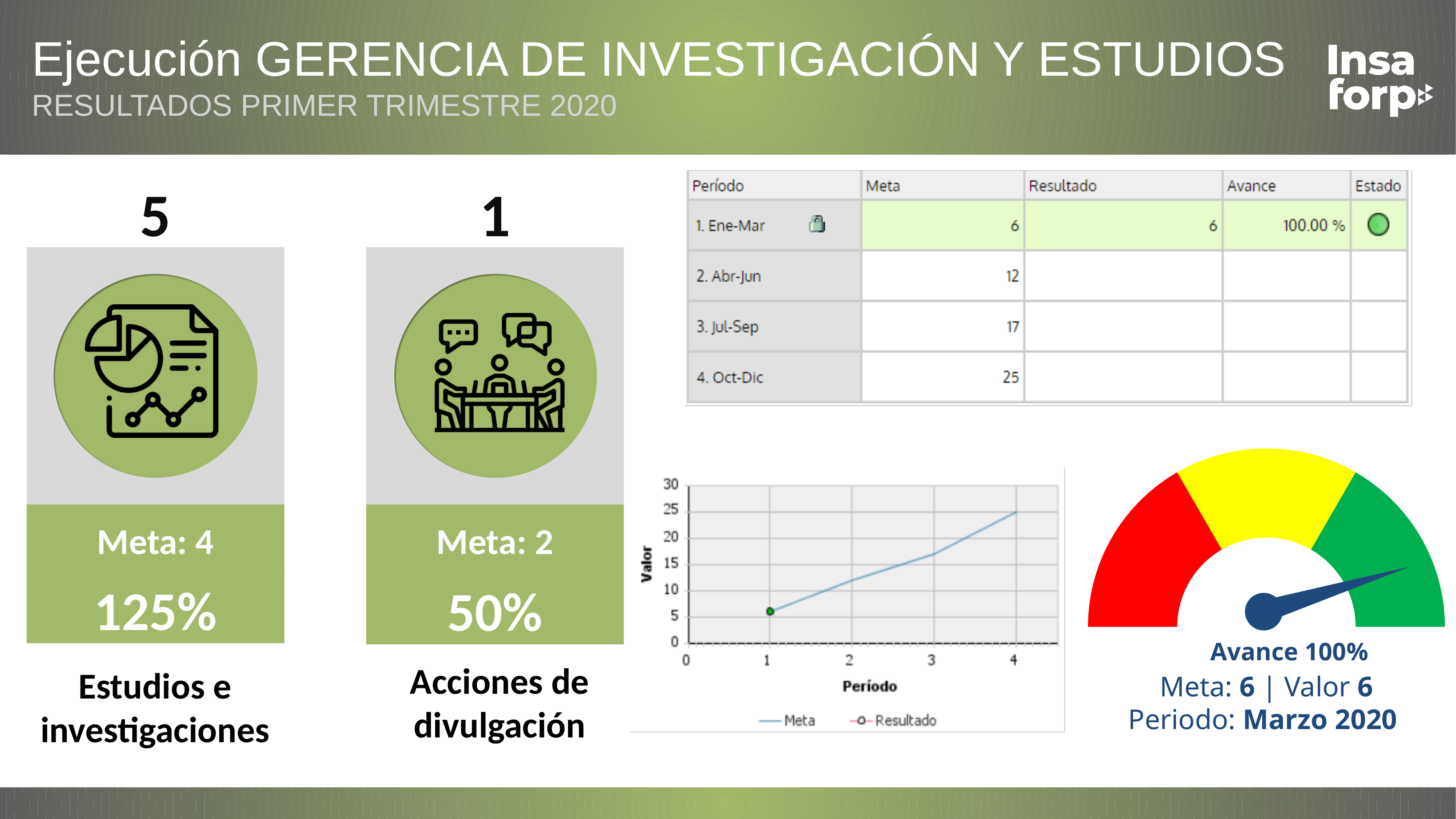
What are the two series named in the line chart's legend? Meta and Resultado In the line chart, at which Período is the Meta value highest? 4 How many periods does the Meta line in the line chart cover? 4 In the line chart, what is the Resultado value at Período 1? 6 Does the Meta line in the line chart rise or fall from Período 1 to Período 4? rise How many series does the legend of the line chart list? 2 What is the label of the y axis of the line chart? Valor In the line chart, is the Meta value at Período 3 greater or less than 15? greater What kind of chart is the chart with the Meta and Resultado series? line chart In the line chart, what is the Meta value at Período 4? 25 In the line chart, is the Meta value at Período 2 greater or less than 15? less In the line chart, at which Período is the Meta value lowest? 1